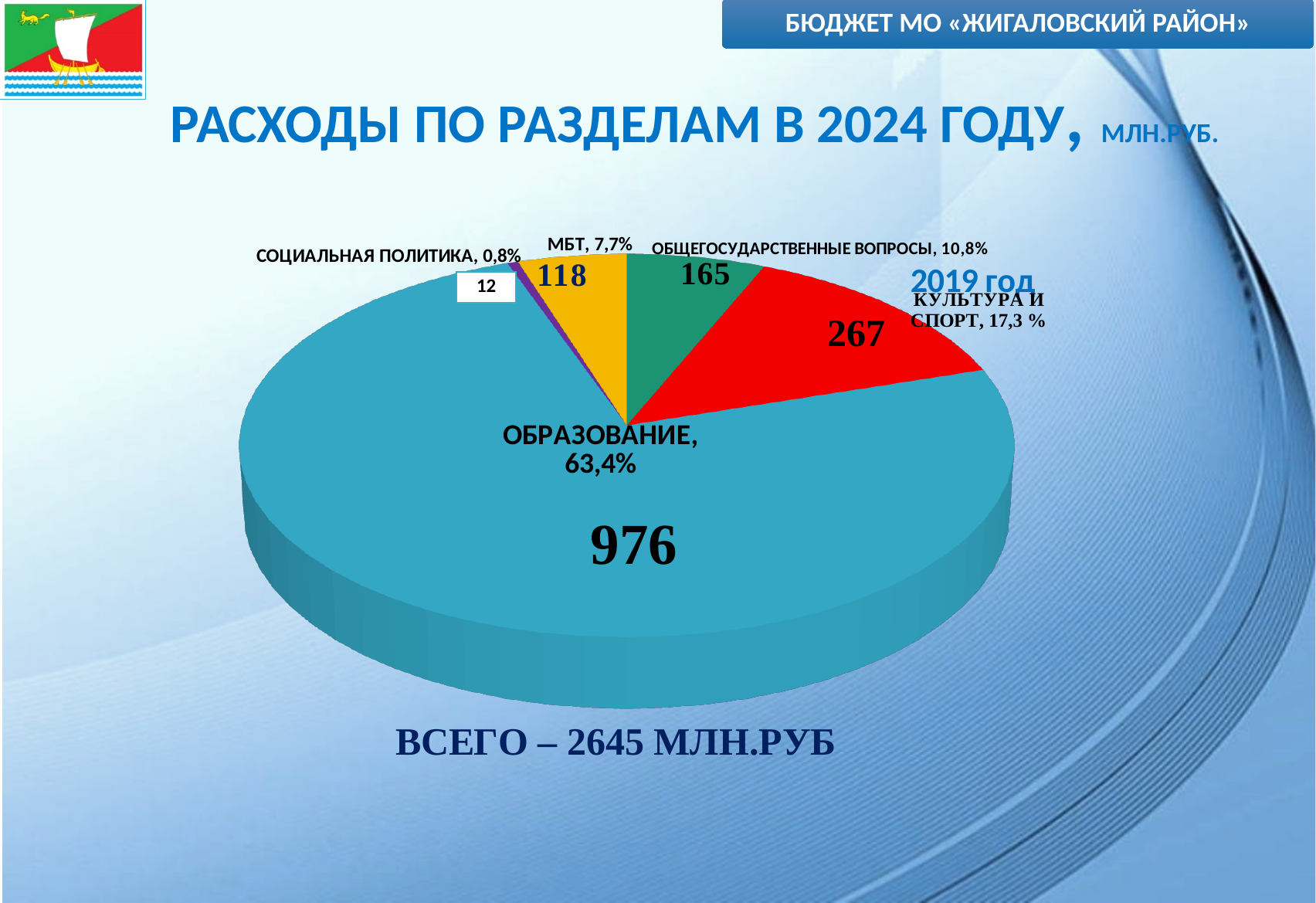
Which category has the smallest slice of the pie? СОЦИАЛЬНАЯ ПОЛИТИКА What share of the pie does ОБРАЗОВАНИЕ take? 63,4% What share of the pie does КУЛЬТУРА И СПОРТ take? 17,3 % What is the value shown for КУЛЬТУРА И СПОРТ? 267 Which category has the largest slice of the pie? ОБРАЗОВАНИЕ What is the value shown for ОБЩЕГОСУДАРСТВЕННЫЕ ВОПРОСЫ? 165 How many categories are shown in the pie chart? 5 What is the value shown for МБТ? 118 What is the difference between the values for КУЛЬТУРА И СПОРТ and ОБЩЕГОСУДАРСТВЕННЫЕ ВОПРОСЫ? 102 What is the value shown for ОБРАЗОВАНИЕ? 976 What is the value shown for СОЦИАЛЬНАЯ ПОЛИТИКА? 12 What kind of chart is shown on the slide? pie chart